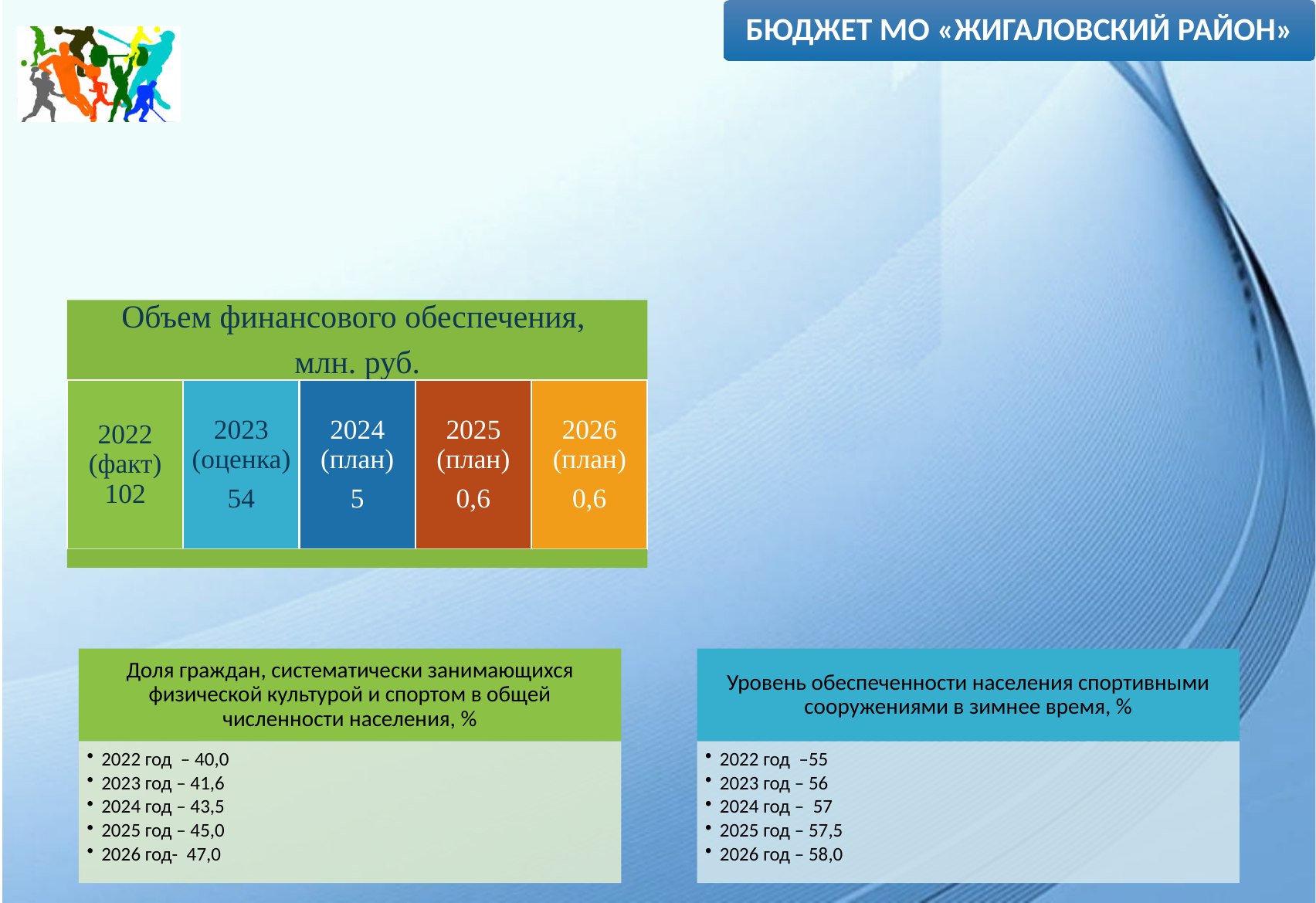
In the chart 'Объем финансового обеспечения, млн. руб.', what is the value for 2022 (факт)? 102 In the chart 'Объем финансового обеспечения, млн. руб.', what is the value for 2024 (план)? 5 In the chart 'Объем финансового обеспечения, млн. руб.', what is the value for 2023 (оценка)? 54 In the chart 'Объем финансового обеспечения, млн. руб.', which year has the highest value? 2022 (факт) In the chart 'Объем финансового обеспечения, млн. руб.', which is larger: the value for 2023 (оценка) or 2024 (план)? 2023 (оценка) In the chart 'Объем финансового обеспечения, млн. руб.', what colour is the 2024 (план) block? blue In the chart 'Объем финансового обеспечения, млн. руб.', do the values rise or fall from 2022 to 2026? fall In the chart 'Объем финансового обеспечения, млн. руб.', what is the value for 2025 (план)? 0,6 In the box 'Уровень обеспеченности населения спортивными сооружениями в зимнее время, %', what is the value for 2025 год? 57,5 In the chart 'Объем финансового обеспечения, млн. руб.', what is the difference between the 2022 (факт) and 2023 (оценка) values? 48 In the box 'Доля граждан, систематически занимающихся физической культурой и спортом в общей численности населения, %', what is the value for 2026 год? 47,0 How many years are shown in the chart 'Объем финансового обеспечения, млн. руб.'? 5